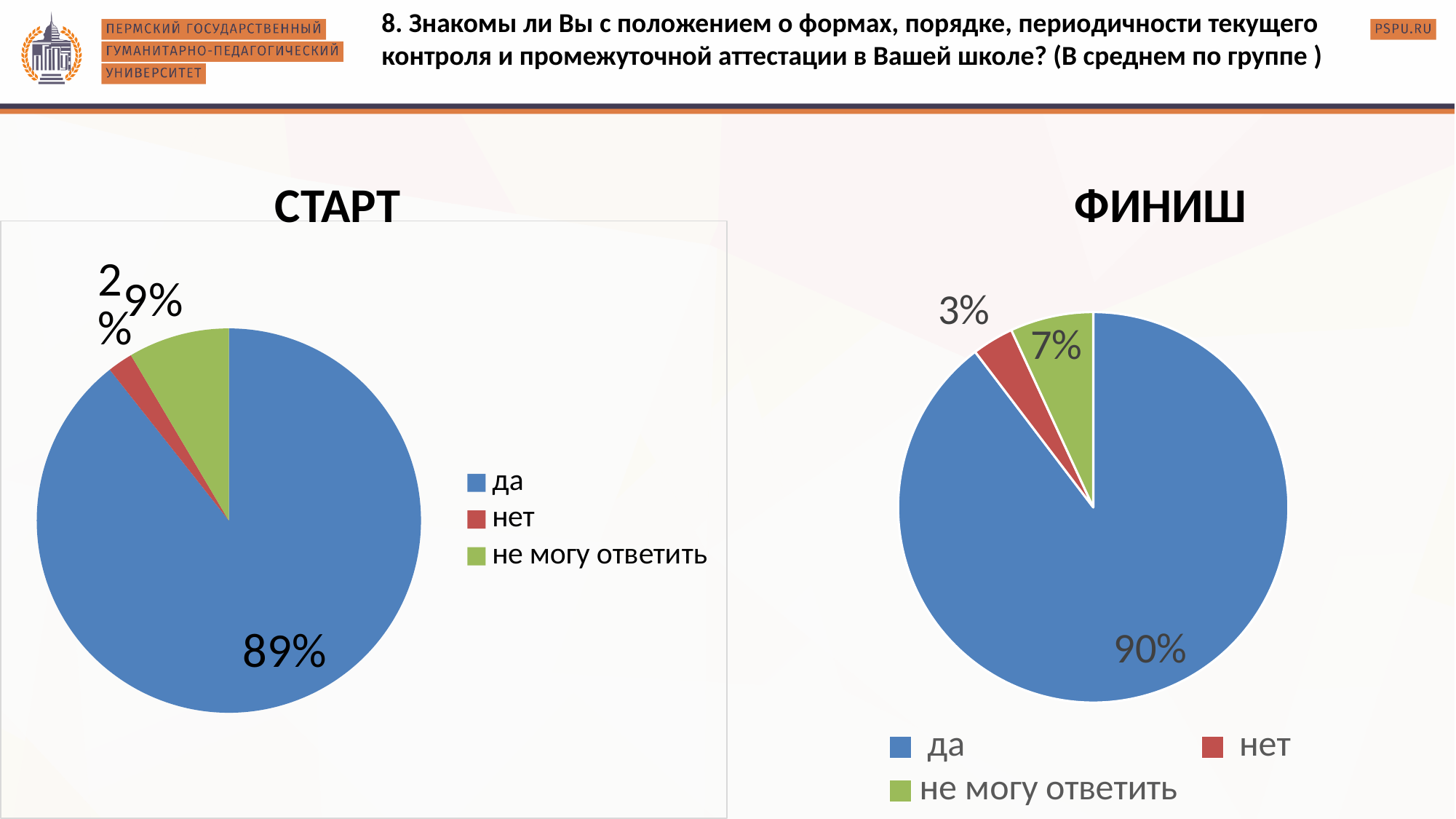
What is the difference between the "да" share in the ФИНИШ chart and the "да" share in the СТАРТ chart? 1% In the ФИНИШ pie chart, what share is labelled for "не могу ответить"? 7% What type of chart is used for the СТАРТ data? Pie chart In the СТАРТ pie chart, what share of respondents answered "да"? 89% How many categories does the legend of the ФИНИШ chart list? 3 Which is larger: the "не могу ответить" share in the СТАРТ chart or in the ФИНИШ chart? СТАРТ In the ФИНИШ pie chart, what share of respondents answered "да"? 90% In the СТАРТ pie chart, what share is labelled for "не могу ответить"? 9% In the ФИНИШ pie chart, what share is labelled for "нет"? 3% In the СТАРТ pie chart, which category has the largest slice? да In the СТАРТ chart legend, which colour represents "нет"? Red In the ФИНИШ pie chart, which category has the smallest slice? нет